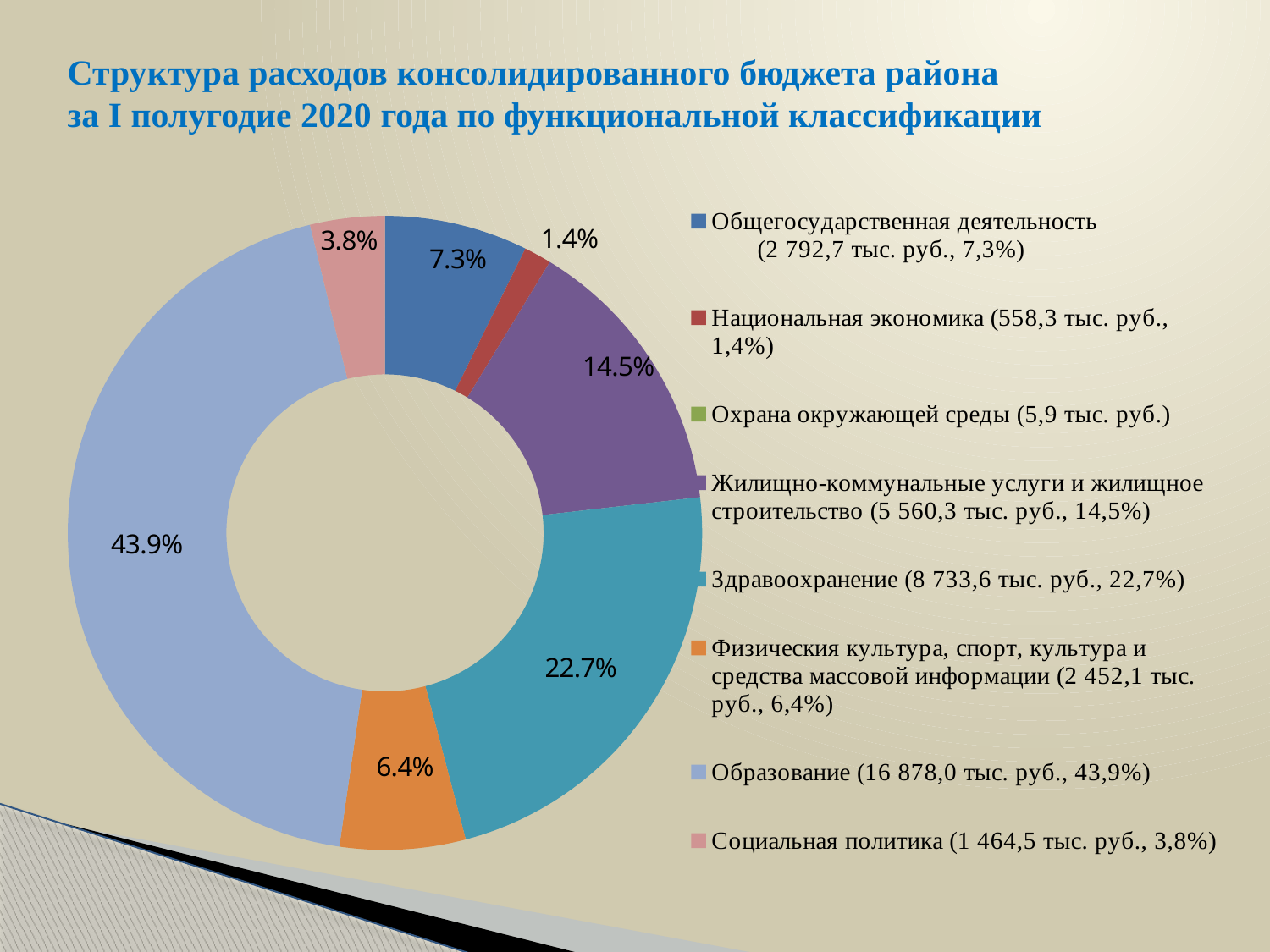
What share of the chart is labelled for Здравоохранение? 22.7% According to the legend, what is the amount in thousand rubles for Здравоохранение? 8 733,6 тыс. руб. How many categories are listed in the chart legend? 8 Which category has the smallest percentage label shown on the chart? Национальная экономика (1.4%) Which has a larger share: Общегосударственная деятельность or Физическая культура, спорт, культура и средства массовой информации? Общегосударственная деятельность What type of chart is shown on the slide? Doughnut (pie) chart What percentage is shown for Социальная политика? 3.8% According to the legend, what is the amount in thousand rubles for Образование? 16 878,0 тыс. руб. Which category has the largest share of the chart? Образование By how many percentage points does the share of Образование exceed the share of Здравоохранение? 21.2 percentage points What percentage is shown for Жилищно-коммунальные услуги и жилищное строительство? 14.5% What percentage of expenditures does Образование account for in the chart? 43.9%